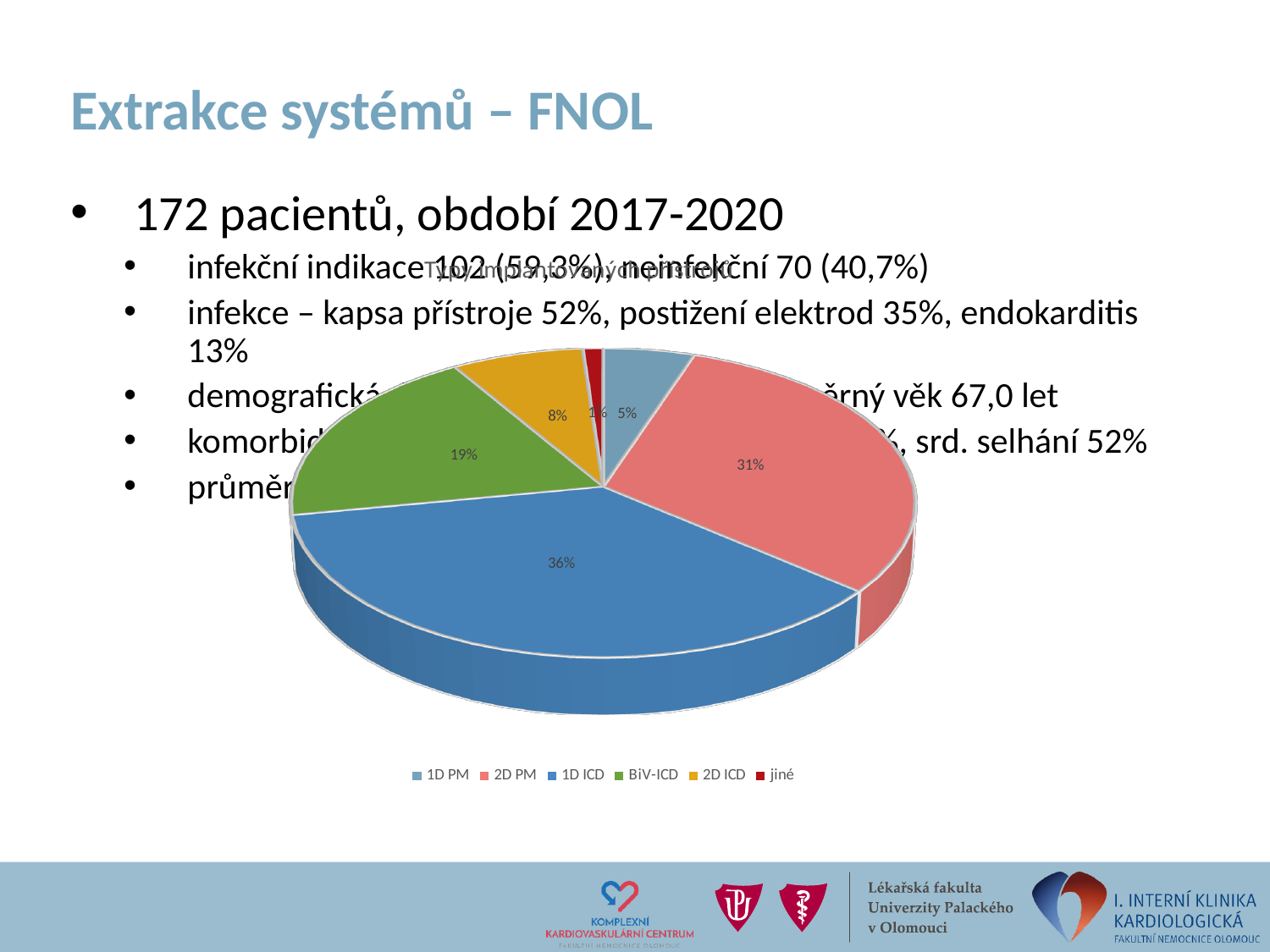
How many categories does the legend of the pie chart list? 6 What colour is the slice for BiV-ICD? green What share of the pie does 2D PM represent? 31% Which category has the smallest slice of the pie? jiné Which category has the largest slice of the pie? 1D ICD Which is larger, the share for 2D PM or the share for BiV-ICD? 2D PM What is the value shown for 2D ICD? 8% What is the difference in percentage points between the 1D ICD slice and the 2D PM slice? 5 What is the value shown for 1D PM? 5% What share of the pie does 1D ICD represent? 36% What is the value shown for BiV-ICD? 19% What kind of chart is shown on the slide? pie chart